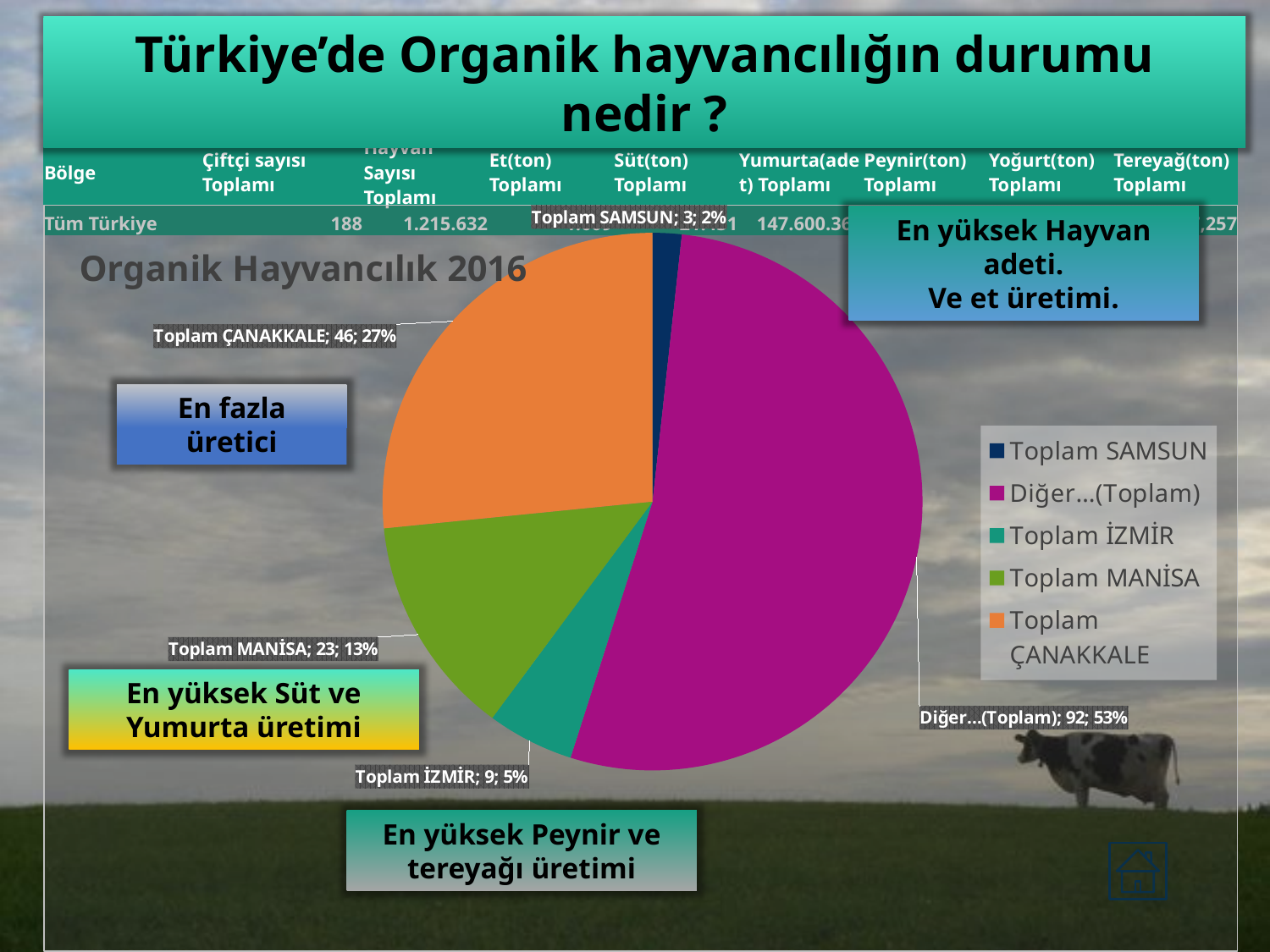
What is the value for Toplam İZMİR? 9 What is the value for Toplam MANİSA? 23 What is the title of the chart? Organik Hayvancılık 2016 What share of the pie does Toplam SAMSUN represent? 2% Which slice is the largest? Diğer...(Toplam) How many slices does the pie chart have? 5 What share of the pie does Diğer...(Toplam) represent? 53% What is the value for Toplam ÇANAKKALE? 46 Which slice is the smallest? Toplam SAMSUN What is the difference between the values for Toplam ÇANAKKALE and Toplam MANİSA? 23 How many entries does the chart legend list? 5 What kind of chart is shown on the slide? pie chart